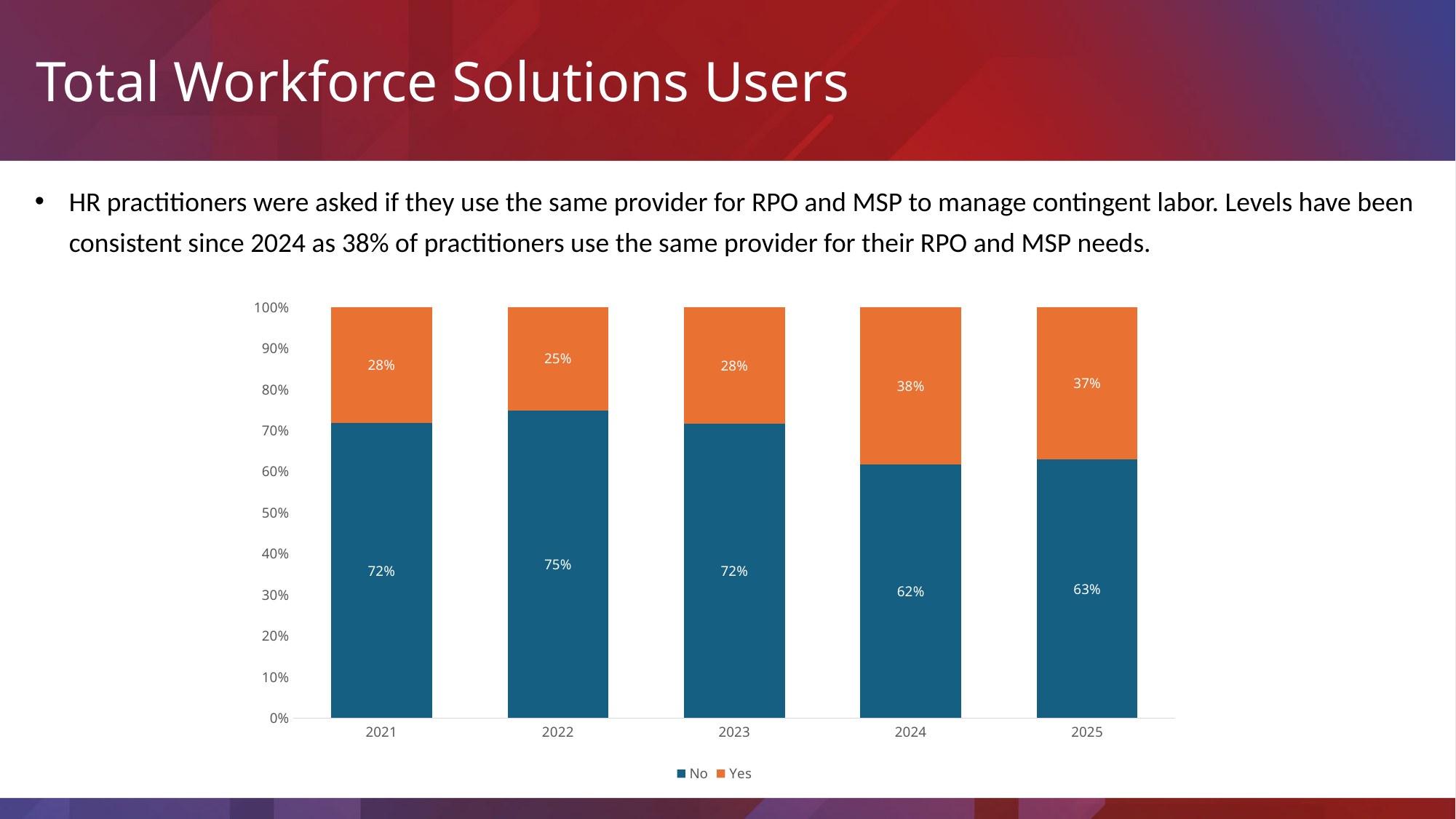
What percentage of practitioners answered "Yes" in 2024? 38% What is the difference between the "No" value in 2021 and the "No" value in 2024? 10% What is the total of the stacked bar for 2023? 100% Which is larger, the "Yes" value for 2023 or the "Yes" value for 2025? 2025 What percentage of practitioners answered "No" in 2022? 75% In which year is the "Yes" share the highest? 2024 What is the "Yes" value for 2025? 37% How many series does the legend list? 2 In which year is the "Yes" share the lowest? 2022 Which colour represents the "Yes" series in the chart? Orange How many years are shown on the x axis? 5 What kind of chart is shown on the slide? Stacked bar chart